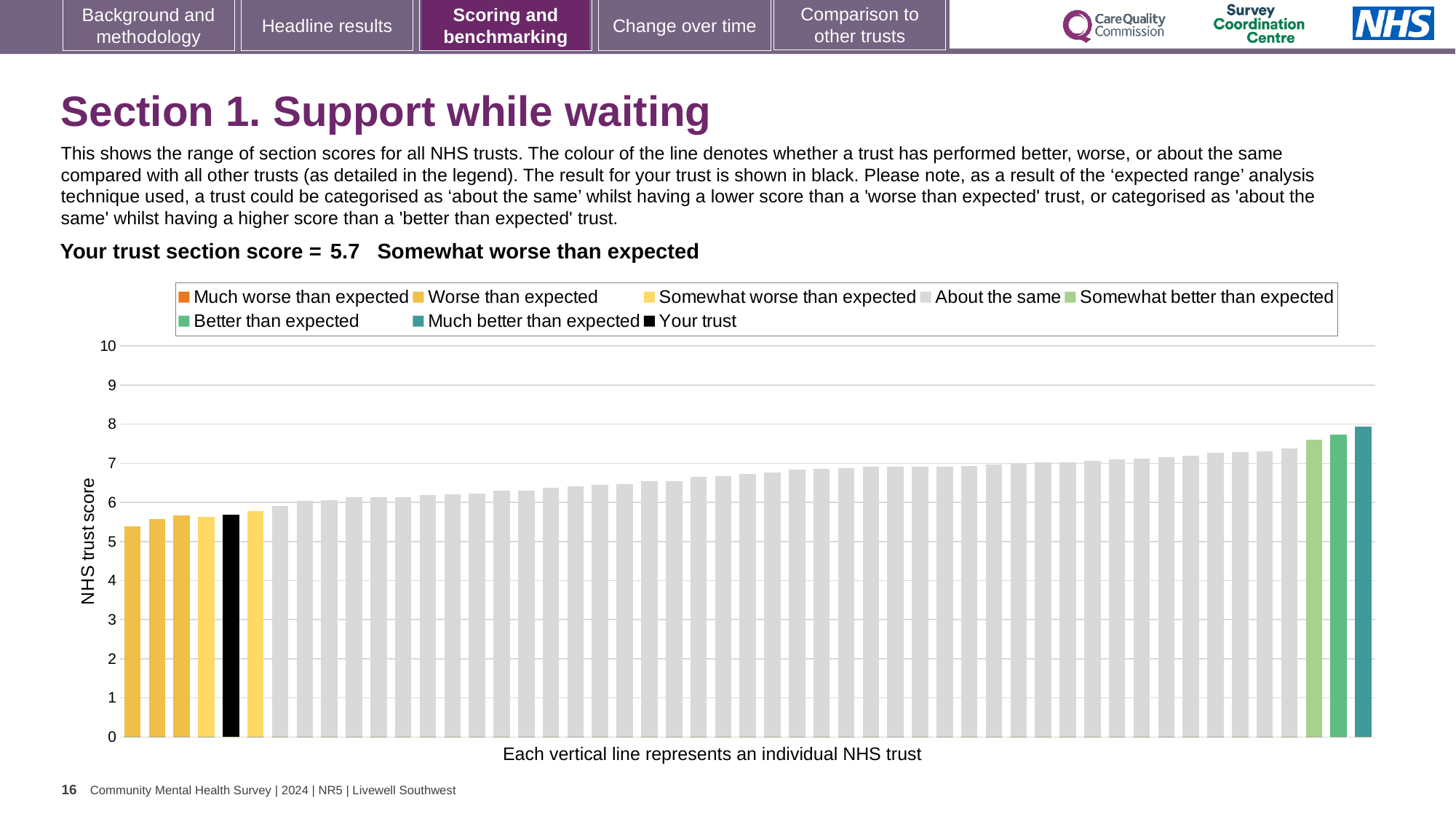
How many entries does the chart legend list? 8 What is the highest tick value shown on the vertical axis? 10 Is the black bar for your trust higher or lower than the tallest bar on the chart? lower Is the value for the shortest bar (far left) greater or less than 5? greater Is the value for the tallest bar (far right) greater or less than 7? greater Which legend category does the trust with the highest score belong to? Much better than expected What is the section score for your trust (the black bar)? 5.7 Is the value for your trust (the black bar) greater or less than 6? less What is the label on the vertical axis of the chart? NHS trust score What kind of chart is shown on the slide? bar chart Which legend category does your trust fall into? Somewhat worse than expected